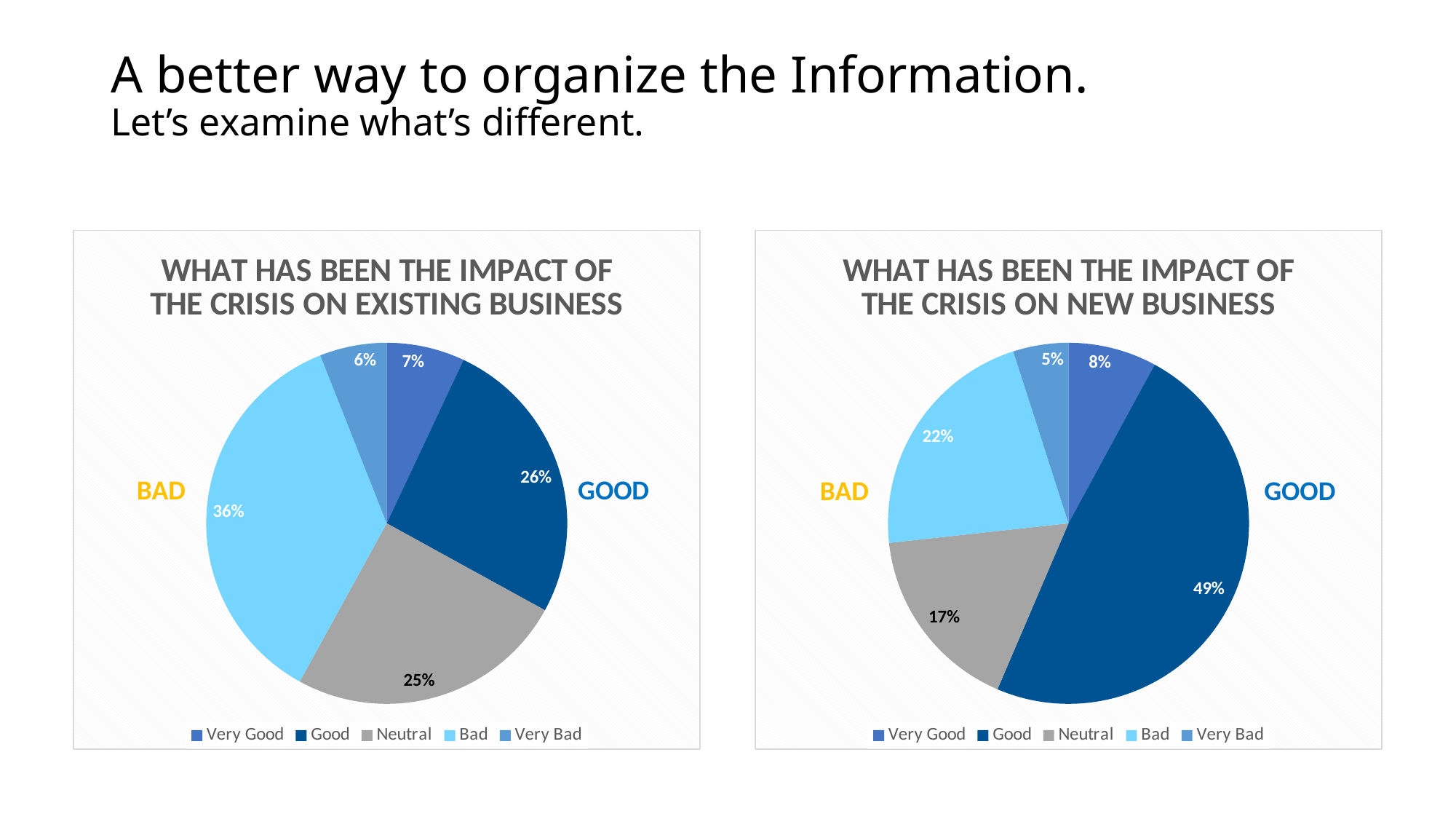
What kind of chart is the chart titled 'What has been the impact of the crisis on new business'? Pie chart In the chart titled 'What has been the impact of the crisis on new business', what is the value for Very Bad? 5% In the chart titled 'What has been the impact of the crisis on existing business', what is the value for Bad? 36% How many categories does the legend list in the chart titled 'What has been the impact of the crisis on existing business'? 5 In the chart titled 'What has been the impact of the crisis on existing business', which is larger, Good or Neutral? Good In the chart titled 'What has been the impact of the crisis on new business', what is the difference between Good and Bad? 27% In the chart titled 'What has been the impact of the crisis on new business', which category has the smallest share? Very Bad In the chart titled 'What has been the impact of the crisis on new business', what is the value for Good? 49% In the chart titled 'What has been the impact of the crisis on existing business', which category has the largest share? Bad In the chart titled 'What has been the impact of the crisis on new business', what colour is the Neutral slice? Grey In the chart titled 'What has been the impact of the crisis on existing business', what is the combined share of Very Good and Good? 33% In the chart titled 'What has been the impact of the crisis on existing business', what is the value for Neutral? 25%